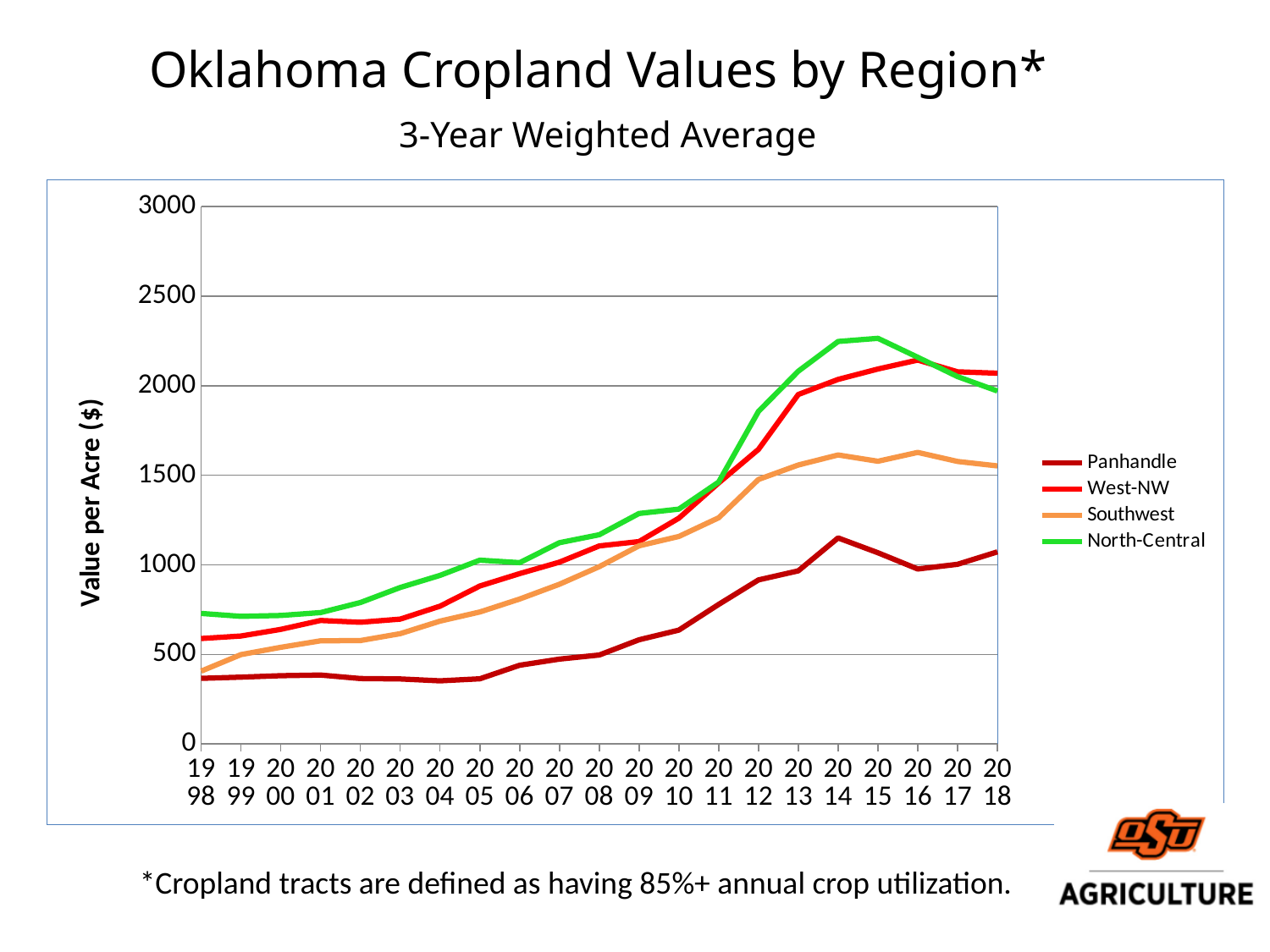
How many series does the legend list? 4 In 2014, which is larger: the North-Central value or the West-NW value? North-Central Which region has the highest value in 2015? North-Central Does the North-Central line rise or fall from 2015 to 2018? fall Which region has the lowest value in 2018? Panhandle What kind of chart is shown on the slide? line chart Is the value for North-Central in 2015 greater or less than 2000? greater How many years are plotted along the x axis? 21 In 2018, which is larger: the West-NW value or the North-Central value? West-NW Is the value for Panhandle in 1998 greater or less than 500? less Is the value for Panhandle in 2018 greater or less than 1000? greater What is the label on the y axis? Value per Acre ($)